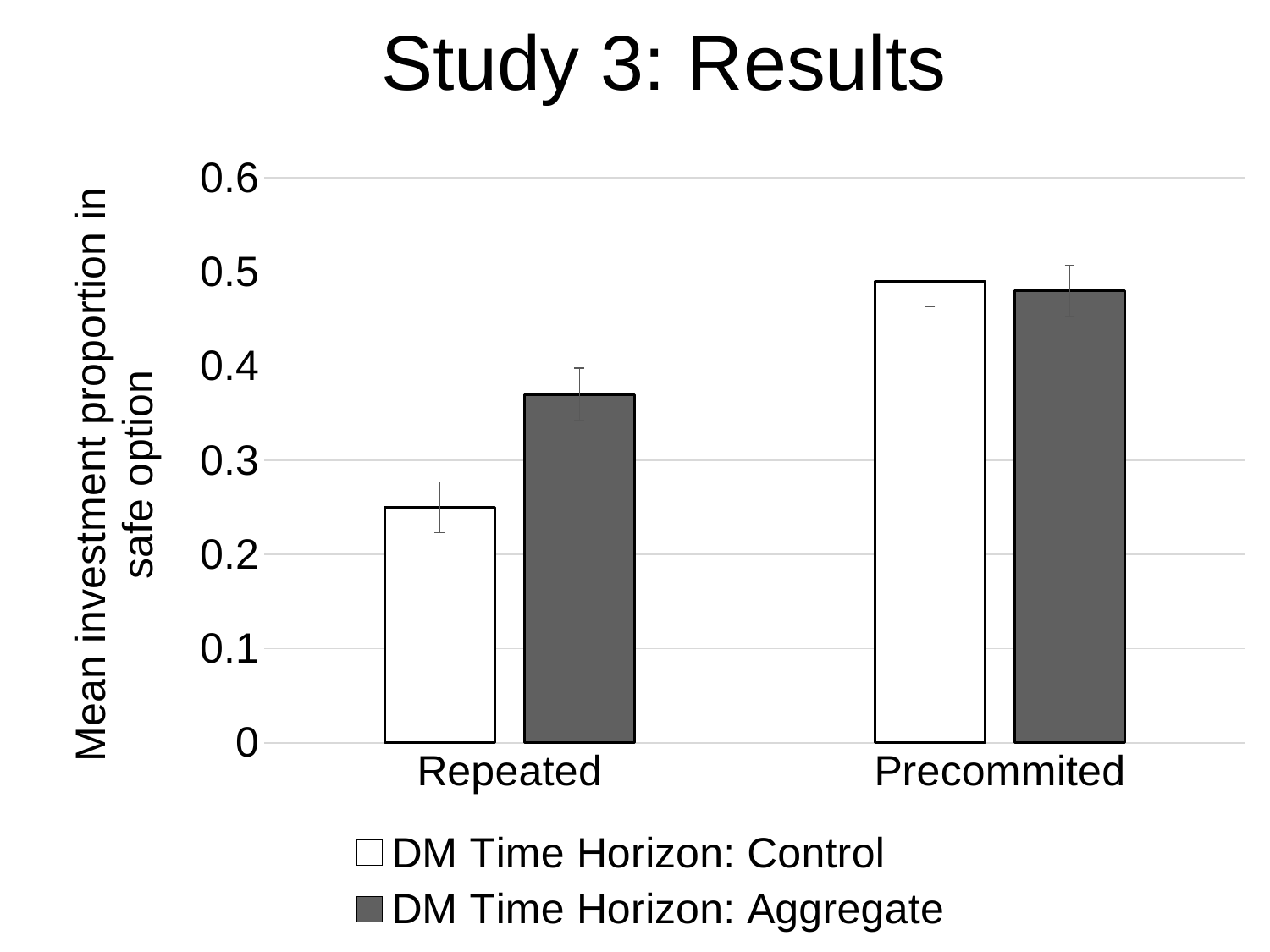
Is the value for DM Time Horizon: Aggregate in the Repeated category greater or less than 0.3? greater What kind of chart is shown on the slide? bar chart What is the label of the y axis? Mean investment proportion in safe option What is the title of the slide? Study 3: Results Which bar is the lowest in the chart? Repeated, DM Time Horizon: Control Is the value for DM Time Horizon: Aggregate in the Precommited category greater or less than 0.4? greater Is the value for DM Time Horizon: Control in the Repeated category greater or less than 0.3? less How many categories are shown on the x axis? 2 For the DM Time Horizon: Control series, which category has the higher value: Repeated or Precommited? Precommited How many series does the legend list? 2 For the DM Time Horizon: Aggregate series, which category has the higher value: Repeated or Precommited? Precommited In the Repeated category, which is larger: DM Time Horizon: Control or DM Time Horizon: Aggregate? DM Time Horizon: Aggregate